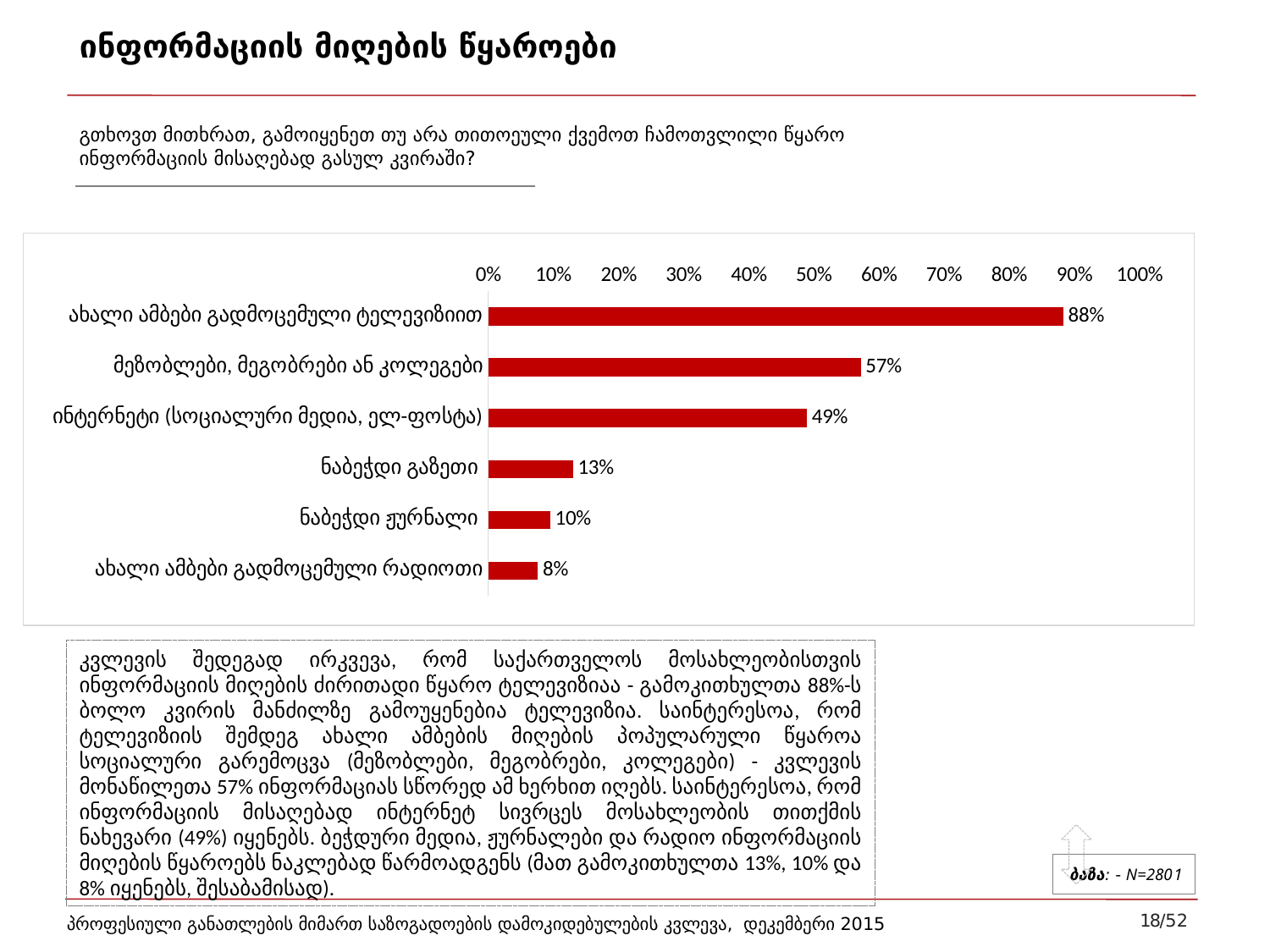
How many categories are shown in the chart? 6 What is the maximum value shown on the percentage axis? 100% Which is larger, the value for ნაბეჭდი გაზეთი or the value for ნაბეჭდი ჟურნალი? ნაბეჭდი გაზეთი What kind of chart is shown on the slide? bar chart What is the value for ინტერნეტი (სოციალური მედია, ელ-ფოსტა)? 49% Is the value for მეზობლები, მეგობრები ან კოლეგები greater or less than 50%? greater Which category has the lowest value? ახალი ამბები გადმოცემული რადიოთი What is the value for ახალი ამბები გადმოცემული ტელევიზიით? 88% What is the value for ნაბეჭდი ჟურნალი? 10% Which category has the highest value? ახალი ამბები გადმოცემული ტელევიზიით What is the title of the slide? ინფორმაციის მიღების წყაროები What is the difference between the values for მეზობლები, მეგობრები ან კოლეგები and ინტერნეტი (სოციალური მედია, ელ-ფოსტა)? 8%